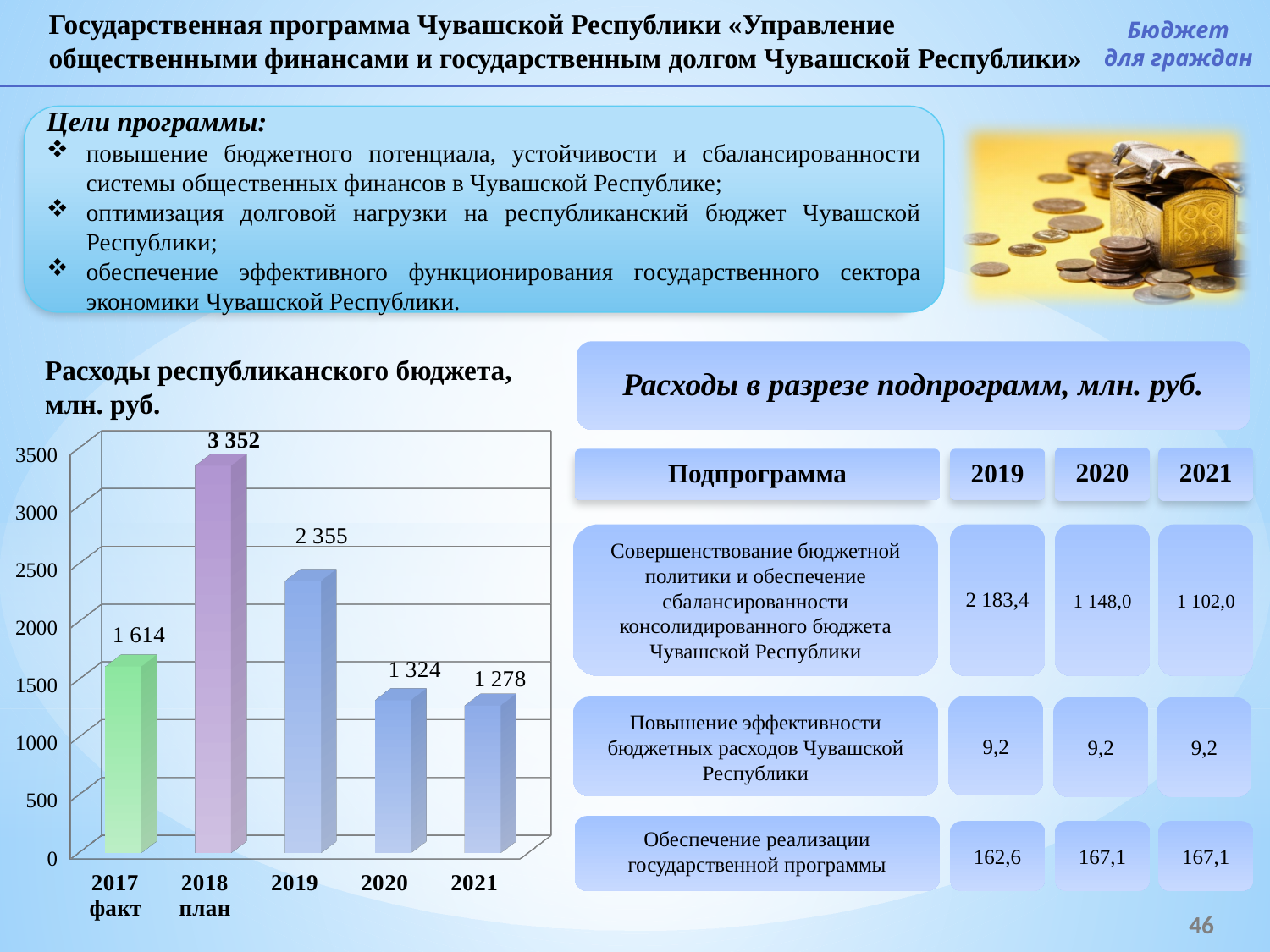
Which year has the lowest value in the chart 'Расходы республиканского бюджета, млн. руб.'? 2021 What is the difference between the values for 2020 and 2021 in the chart 'Расходы республиканского бюджета, млн. руб.'? 46 Which year has the highest value in the chart 'Расходы республиканского бюджета, млн. руб.'? 2018 план What kind of chart is 'Расходы республиканского бюджета, млн. руб.'? bar chart How many bars are shown in the chart 'Расходы республиканского бюджета, млн. руб.'? 5 What is the value for 2018 план in the chart 'Расходы республиканского бюджета, млн. руб.'? 3 352 Which is larger in the chart 'Расходы республиканского бюджета, млн. руб.': the value for 2017 факт or the value for 2019? 2019 What is the value for 2021 in the chart 'Расходы республиканского бюджета, млн. руб.'? 1 278 What is the difference between the values for 2018 план and 2019 in the chart 'Расходы республиканского бюджета, млн. руб.'? 997 What is the value for 2017 факт in the chart 'Расходы республиканского бюджета, млн. руб.'? 1 614 Do the values in the chart 'Расходы республиканского бюджета, млн. руб.' rise or fall from 2019 to 2021? fall Is the value for 2019 in the chart 'Расходы республиканского бюджета, млн. руб.' greater or less than 2000? greater